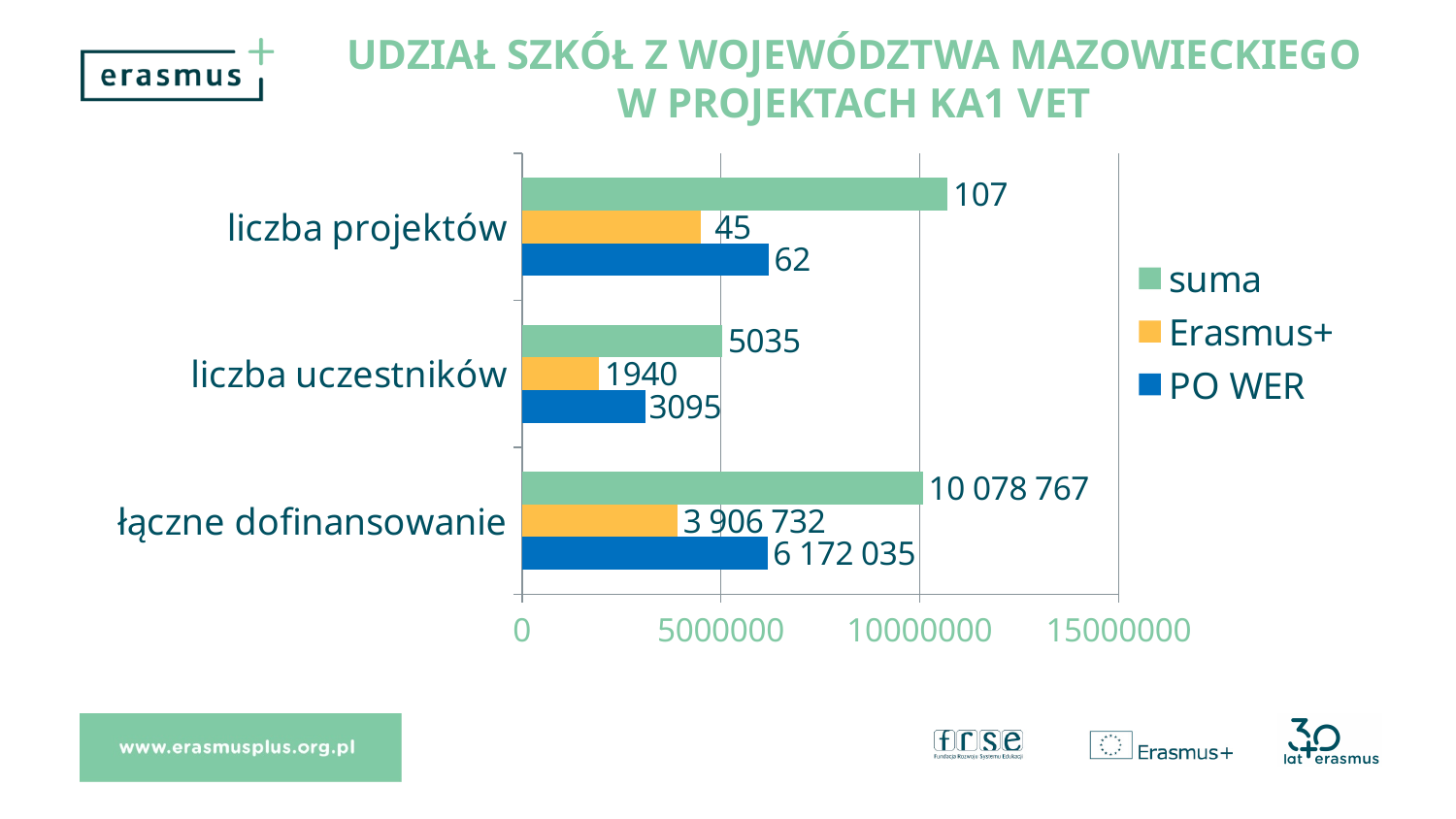
What kind of chart is shown on the slide? Bar chart What is the value of the suma series for liczba projektów? 107 What is the PO WER value for liczba projektów? 62 How many categories are shown on the chart? 3 What is the suma value for łączne dofinansowanie? 10 078 767 Which is larger for łączne dofinansowanie, the Erasmus+ value or the PO WER value? PO WER What is the difference between the PO WER and Erasmus+ values for liczba uczestników? 1155 Which series has the lowest value for liczba uczestników? Erasmus+ How many series does the legend list? 3 What is the Erasmus+ value for liczba uczestników? 1940 What is the difference between the PO WER and Erasmus+ values for liczba projektów? 17 What is the PO WER value for łączne dofinansowanie? 6 172 035